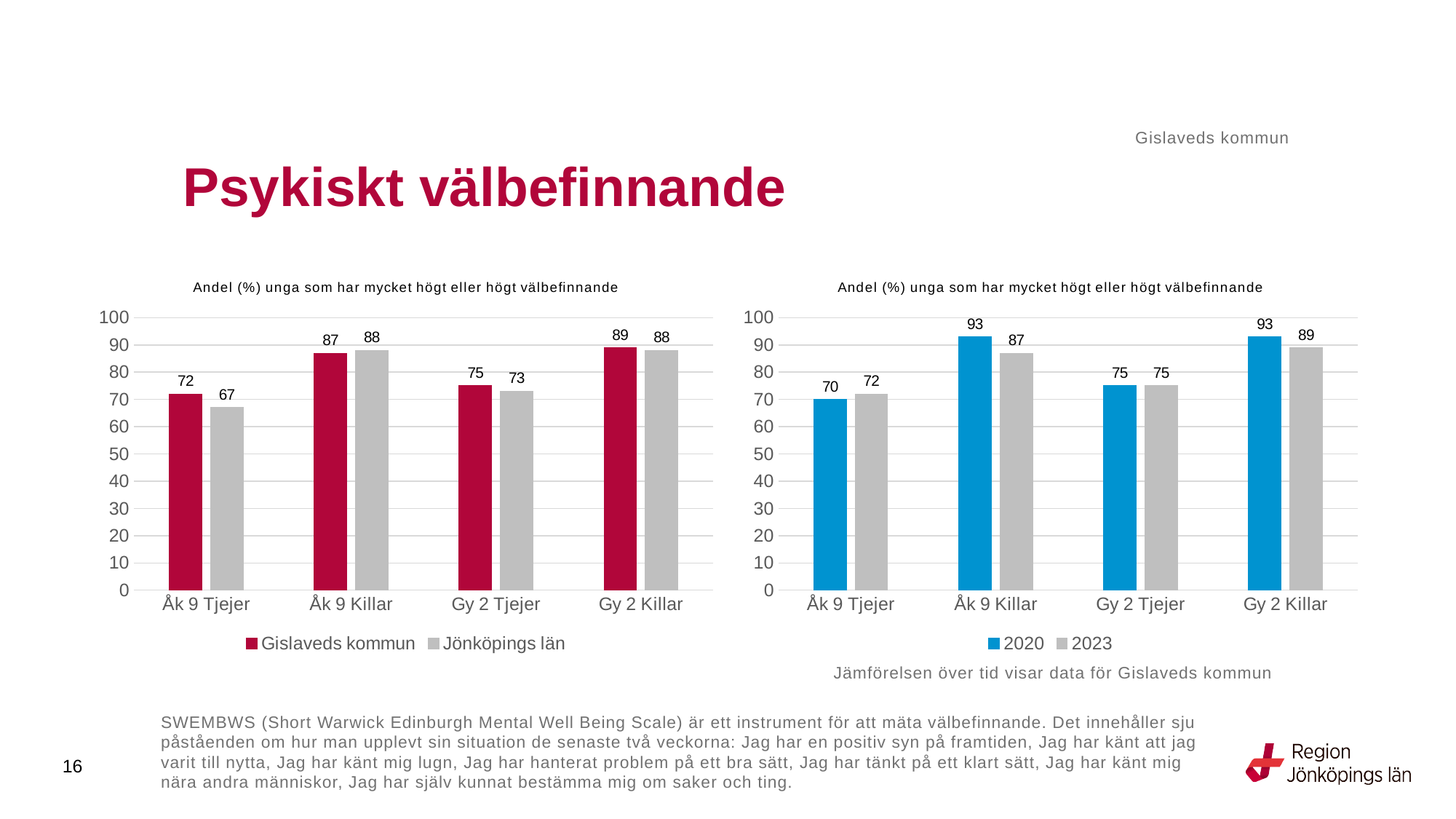
In the right chart, what is the difference between the 2020 and 2023 values for Åk 9 Killar? 6 In the right chart, how many categories are shown on the x axis? 4 In the left chart, which category has the lowest value for Jönköpings län? Åk 9 Tjejer In the right chart, what is the 2020 value for Åk 9 Killar? 93 In the right chart, what is the 2023 value for Gy 2 Killar? 89 In the left chart, how many series does the legend list? 2 What kind of chart is the right chart? Bar chart In the left chart, what is the difference between Gislaveds kommun and Jönköpings län for Åk 9 Tjejer? 5 In the left chart, what is the value for Jönköpings län for Gy 2 Tjejer? 73 In the left chart, what is the value for Gislaveds kommun for Åk 9 Tjejer? 72 In the left chart, which category has the highest value for Gislaveds kommun? Gy 2 Killar In the right chart, which is larger for Åk 9 Tjejer, the 2020 value or the 2023 value? 2023